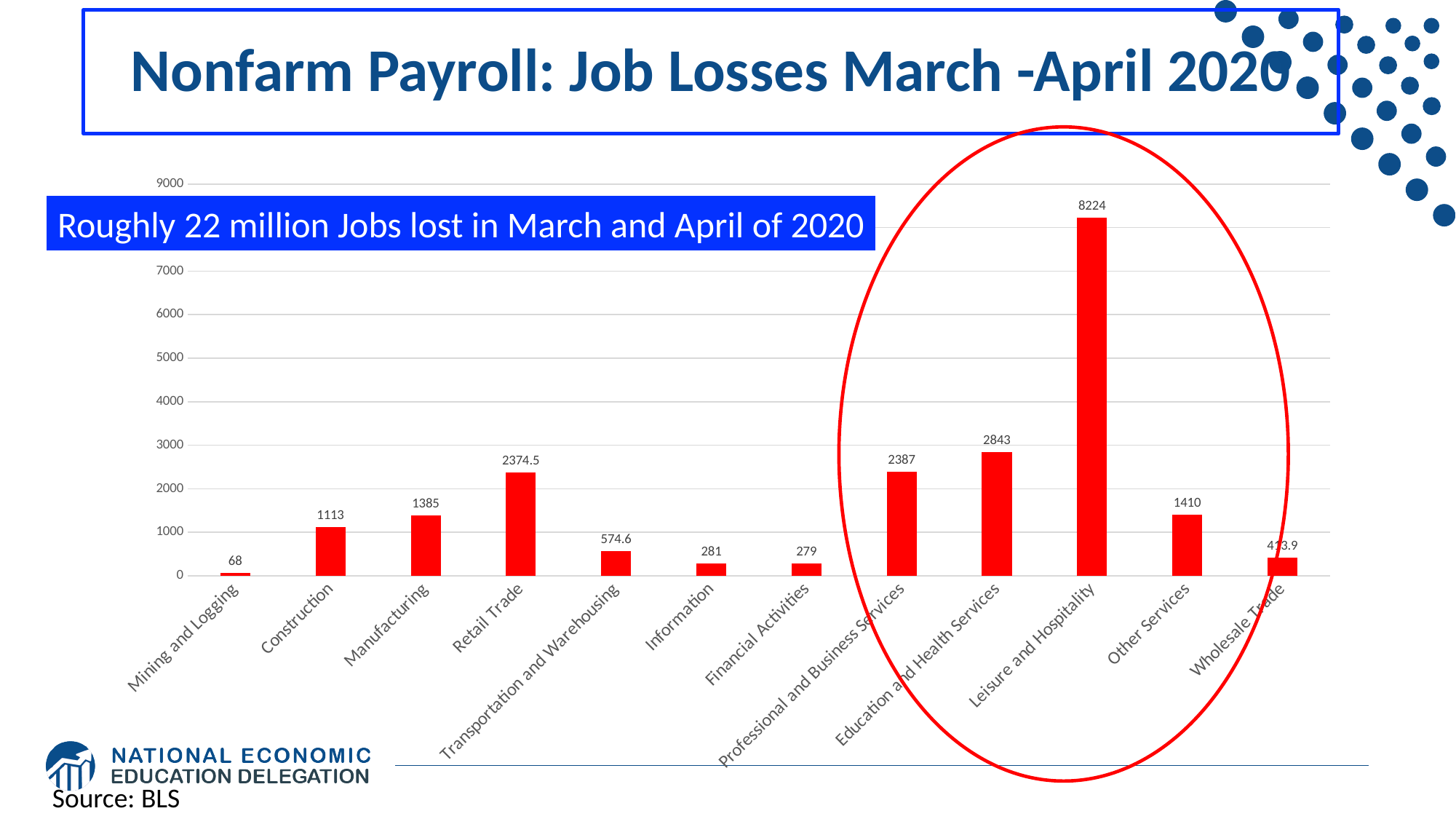
Which is larger, the value for Manufacturing or the value for Construction? Manufacturing How many categories are shown on the x axis? 12 Which category has the lowest value? Mining and Logging What is the difference between the values for Education and Health Services and Professional and Business Services? 456 What is the value for Transportation and Warehousing? 574.6 What kind of chart is shown on the slide? bar chart What is the value for Retail Trade? 2374.5 What is the value for Leisure and Hospitality? 8224 Is the value for Wholesale Trade greater or less than 1000? less How much larger is the value for Leisure and Hospitality than the value for Education and Health Services? 5381 Which category has the highest value? Leisure and Hospitality What is the value for Other Services? 1410